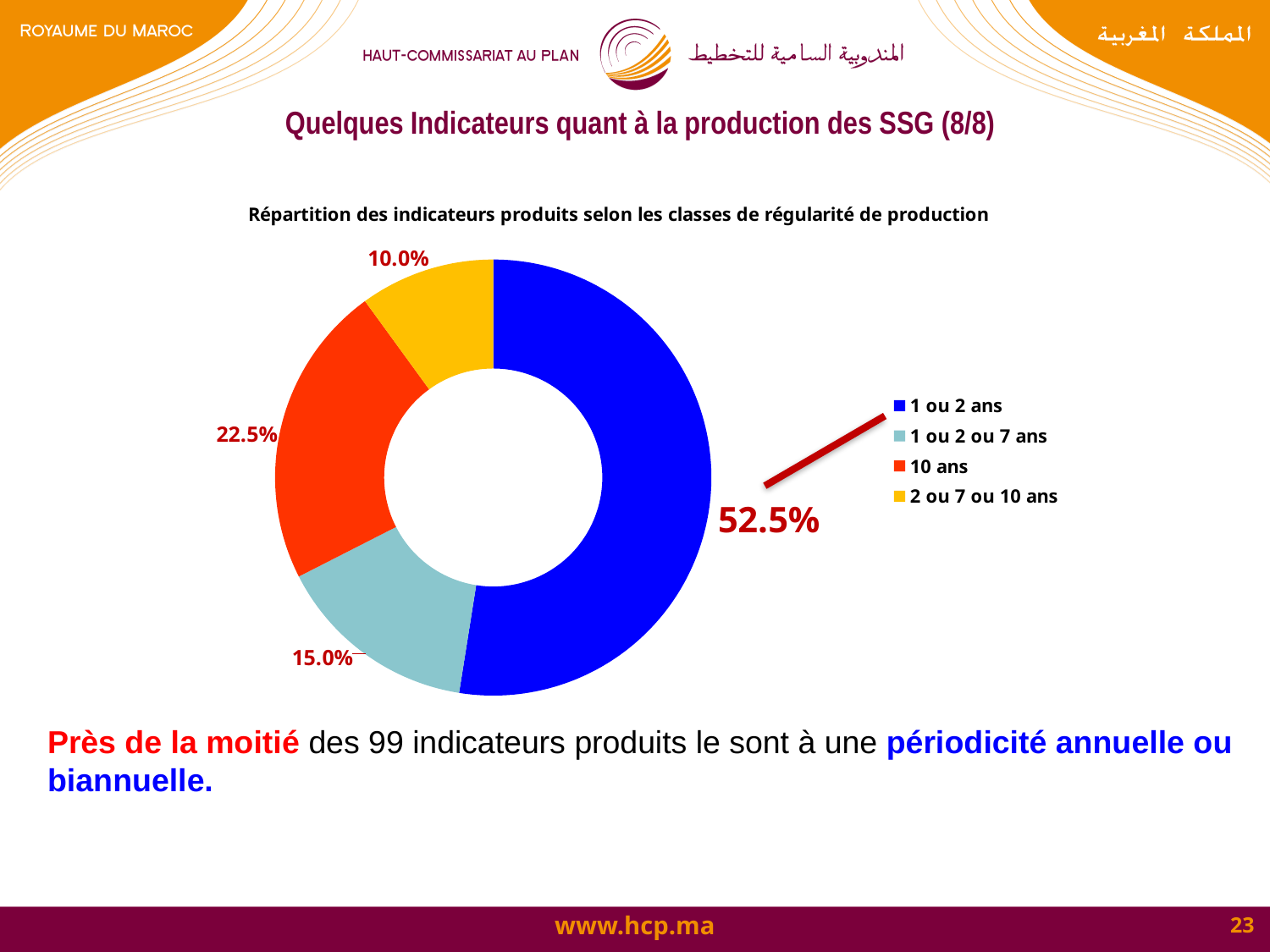
What is the difference in percentage points between the 1 ou 2 ans share and the 10 ans share? 30 percentage points What share of the indicators falls in the 2 ou 7 ou 10 ans class? 10.0% What share of the indicators falls in the 1 ou 2 ou 7 ans class? 15.0% Which class has a larger share: 10 ans or 1 ou 2 ou 7 ans? 10 ans What share of the indicators falls in the 10 ans class? 22.5% Which regularity class has the largest share of indicators? 1 ou 2 ans Which regularity class has the smallest share of indicators? 2 ou 7 ou 10 ans What share of the indicators is produced every 1 ou 2 ans? 52.5% How many regularity classes are shown in the chart? 4 Which colour represents the 10 ans class in the chart? Red (orange-red) What is the title of the chart? Répartition des indicateurs produits selon les classes de régularité de production What type of chart is used to show the distribution of indicators by regularity class? Doughnut (pie) chart